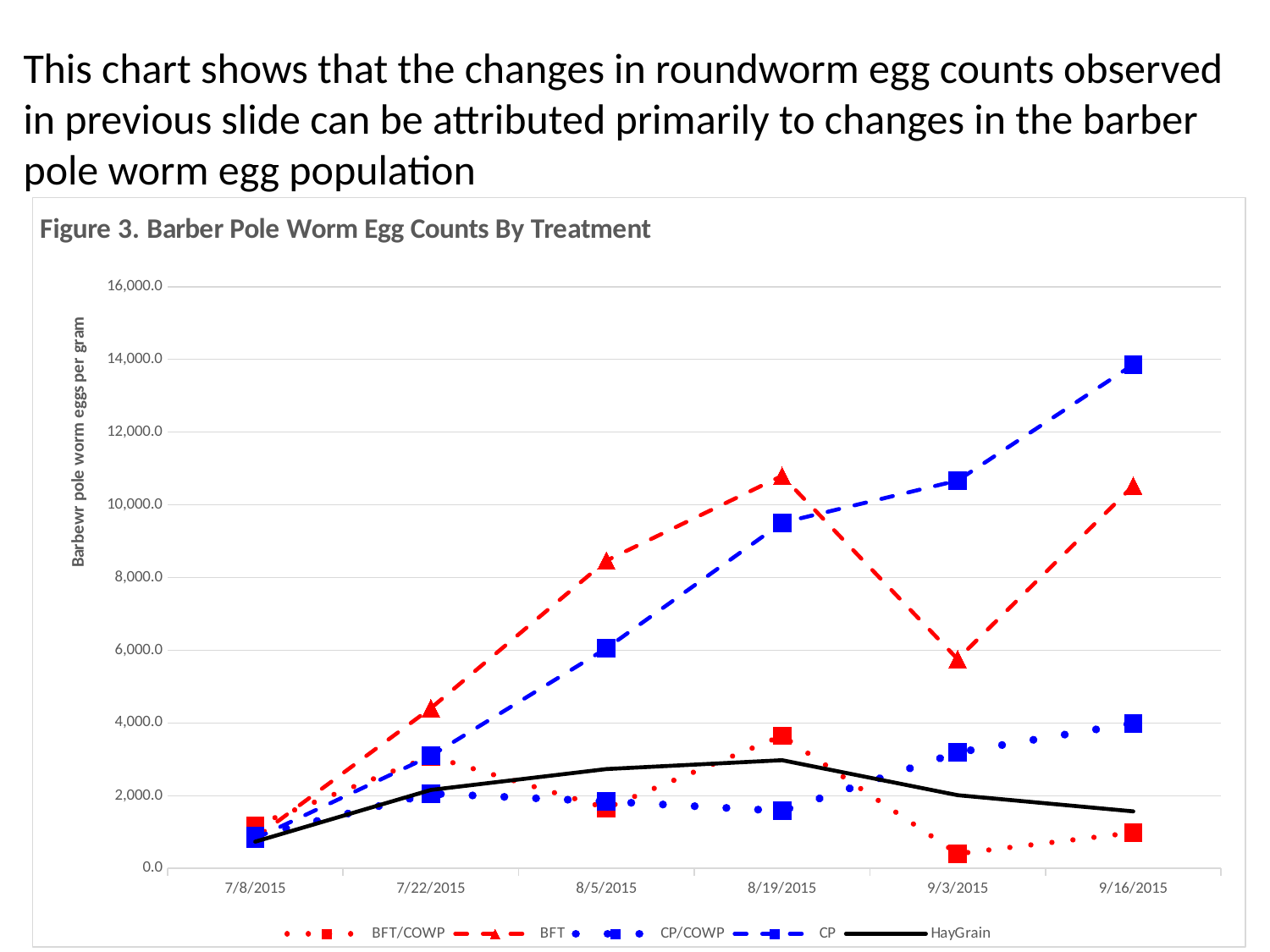
Is the value for CP on 9/16/2015 greater or less than 12,000.0? greater Which treatment has the highest egg count on 9/16/2015? CP What is the title of the chart? Figure 3. Barber Pole Worm Egg Counts By Treatment Is the value for BFT on 9/3/2015 greater or less than 6,000.0? less Does the CP series rise or fall from 7/8/2015 to 9/16/2015? rise Which treatment has the highest egg count on 8/19/2015? BFT Is the value for CP on 8/19/2015 greater or less than 10,000.0? less On 8/19/2015, which is larger, the value for BFT or the value for CP? BFT How many series does the legend list? 5 How many dates are shown on the x axis? 6 Which treatment has the lowest egg count on 9/3/2015? BFT/COWP What kind of chart is shown on the slide? line chart